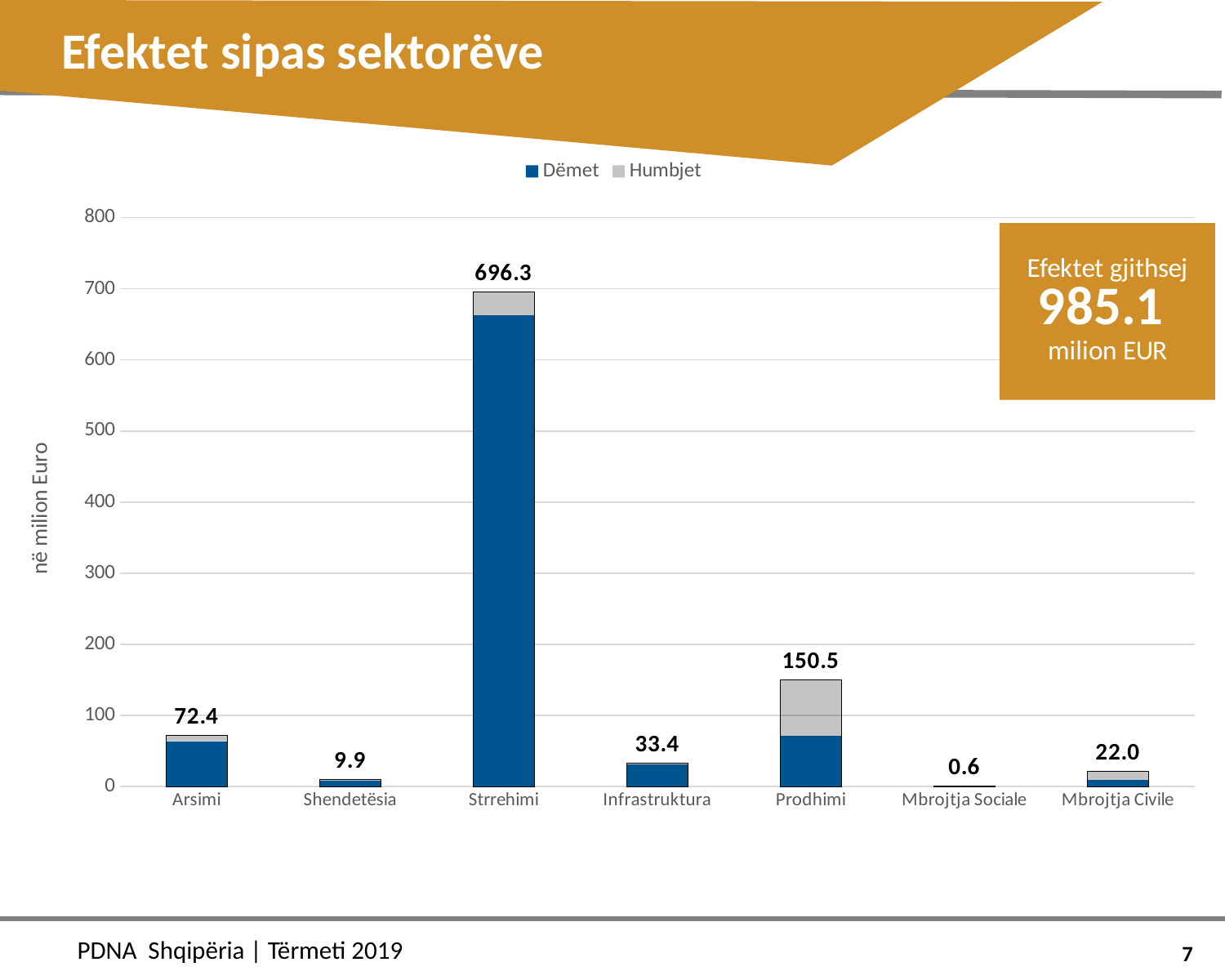
How many sectors are shown on the x axis? 7 What is the total value shown for Strrehimi? 696.3 What is the total value shown for Prodhimi? 150.5 What is the total value shown for Infrastruktura? 33.4 What is the total value shown for Mbrojtja Sociale? 0.6 Which sector has the lowest total value? Mbrojtja Sociale Which has a larger total value, Arsimi or Mbrojtja Civile? Arsimi What is the difference between the total for Strrehimi and the total for Prodhimi? 545.8 Is the Dëmet value for Strrehimi greater or less than 600? greater Which sector has the highest total value? Strrehimi What kind of chart is shown on the slide? Stacked bar chart How many series does the legend list? 2